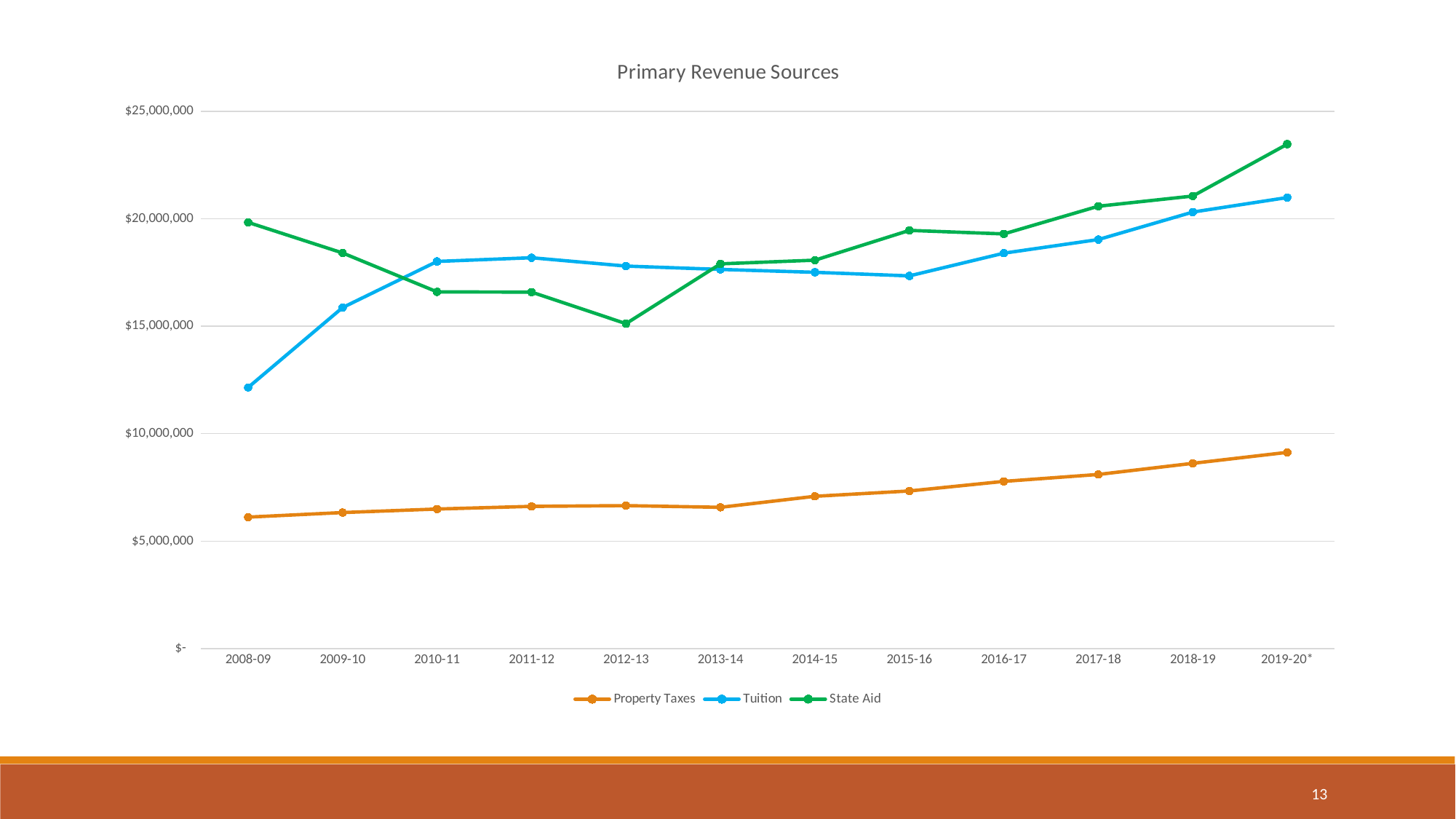
In 2010-11, which is larger, Tuition or State Aid? Tuition Is the value for Tuition in 2008-09 greater or less than $15,000,000? less Do Property Taxes generally rise or fall from 2008-09 to 2019-20*? rise In which year is Tuition at its lowest? 2008-09 In which year is State Aid at its lowest? 2012-13 How many series does the legend list? 3 How many fiscal years are plotted along the x axis? 12 Which series has the highest value in 2019-20*? State Aid What is the title of the chart? Primary Revenue Sources Is the value for State Aid in 2019-20* greater or less than $20,000,000? greater In 2008-09, which is larger, State Aid or Tuition? State Aid What kind of chart is shown on the slide? line chart